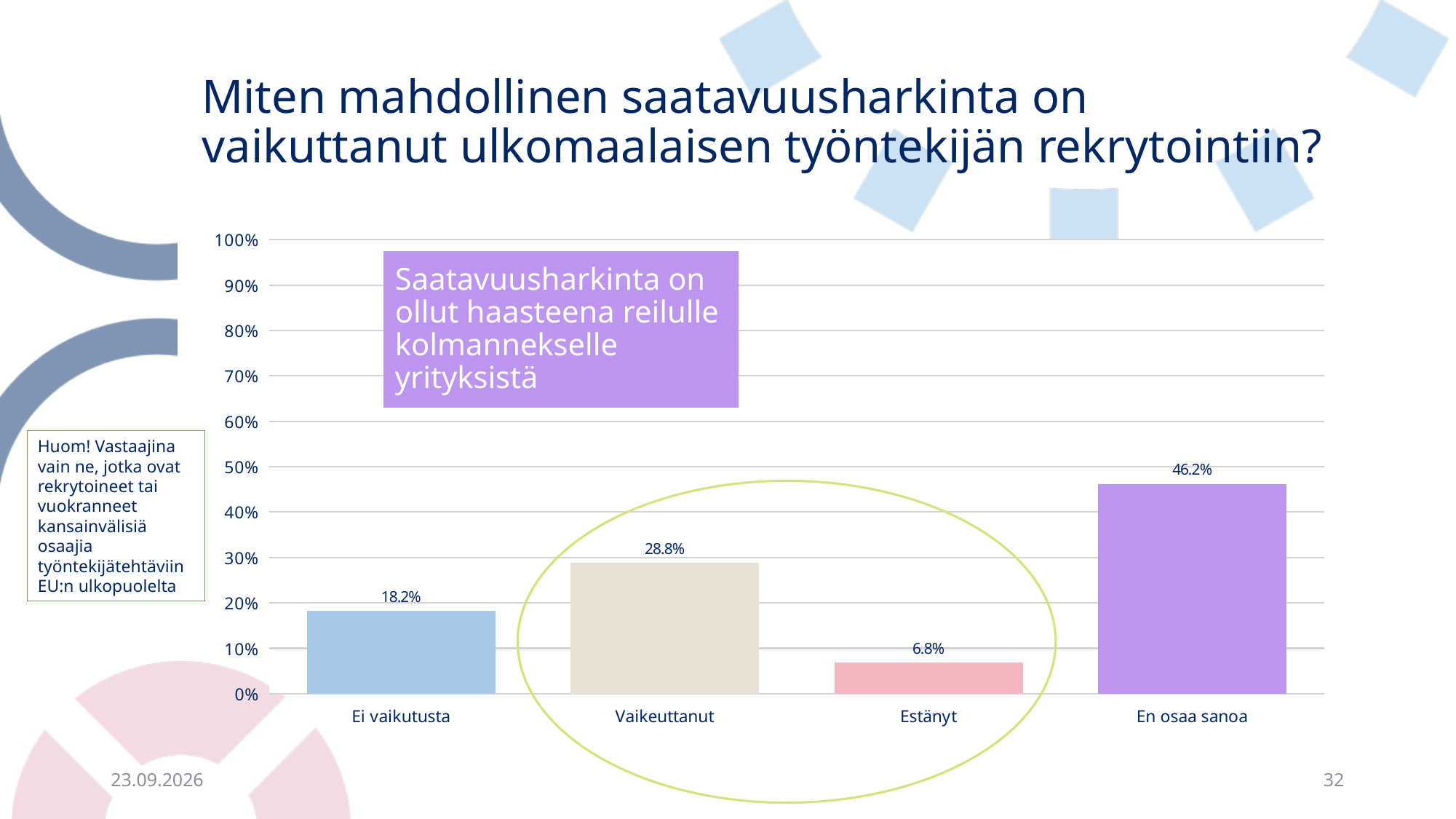
How many categories are shown on the x axis? 4 Is the value for En osaa sanoa greater or less than 40%? greater What is the value for Ei vaikutusta? 18.2% What is the value for En osaa sanoa? 46.2% What is the value for Vaikeuttanut? 28.8% Which is larger, the value for Ei vaikutusta or the value for Vaikeuttanut? Vaikeuttanut Which category has the highest value? En osaa sanoa What kind of chart is shown on the slide? bar chart Which two categories are enclosed by the green ellipse on the chart? Vaikeuttanut and Estänyt What is the difference between the values for Vaikeuttanut and Estänyt? 22.0% What is the value for Estänyt? 6.8% Which category has the lowest value? Estänyt